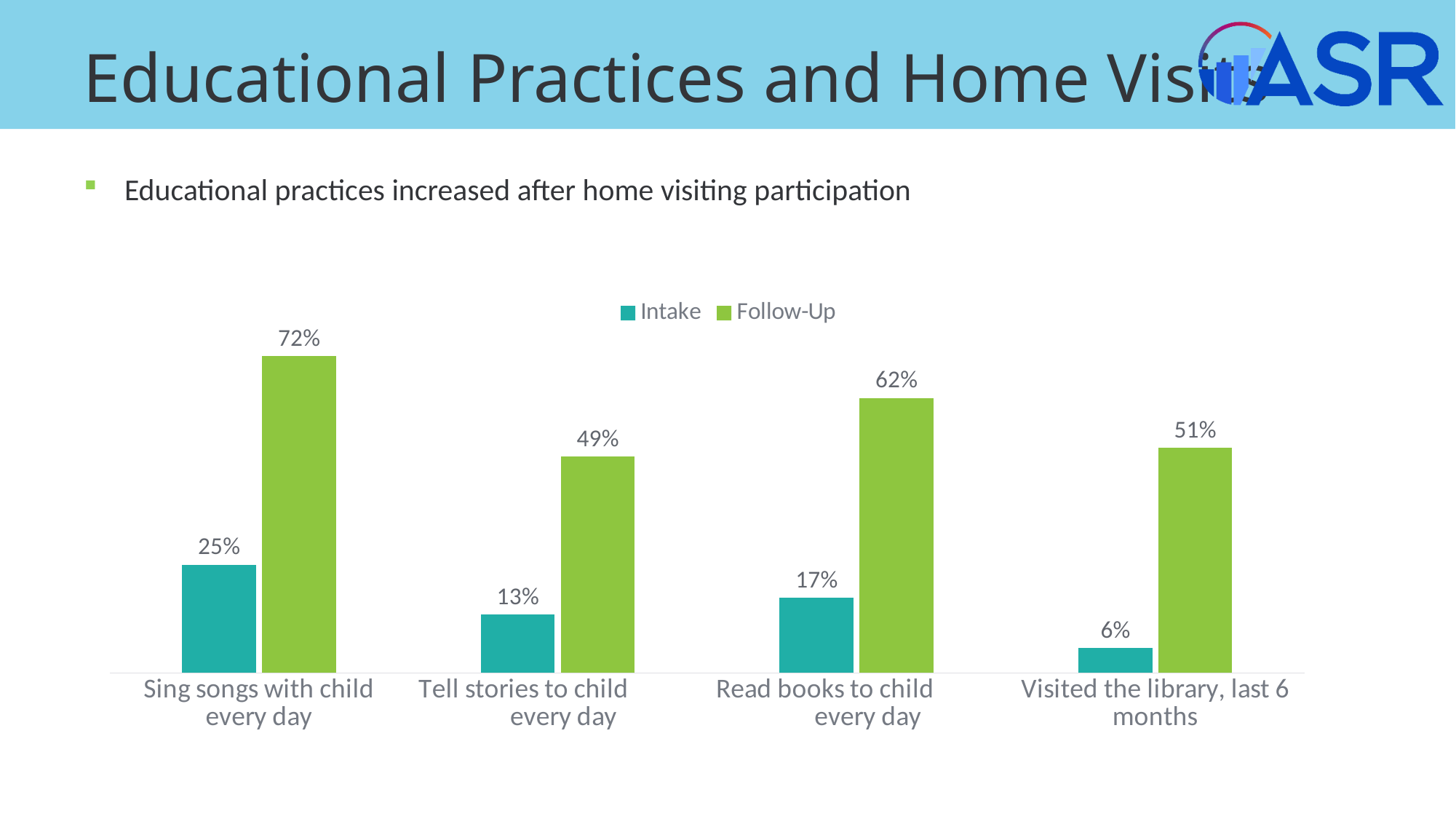
What is the Follow-Up value for "Tell stories to child every day"? 49% What kind of chart is shown on the slide? Bar chart What is the difference between the Follow-Up and Intake values for "Visited the library, last 6 months"? 45% Which category has the lowest Intake value? Visited the library, last 6 months What is the difference between the Follow-Up and Intake values for "Sing songs with child every day"? 47% What is the Intake value for "Sing songs with child every day"? 25% What is the Follow-Up value for "Read books to child every day"? 62% Which is larger: the Intake value for "Read books to child every day" or the Intake value for "Tell stories to child every day"? Read books to child every day What is the Intake value for "Visited the library, last 6 months"? 6% How many categories are shown on the x axis? 4 How many series does the legend list? 2 Which category has the highest Follow-Up value? Sing songs with child every day